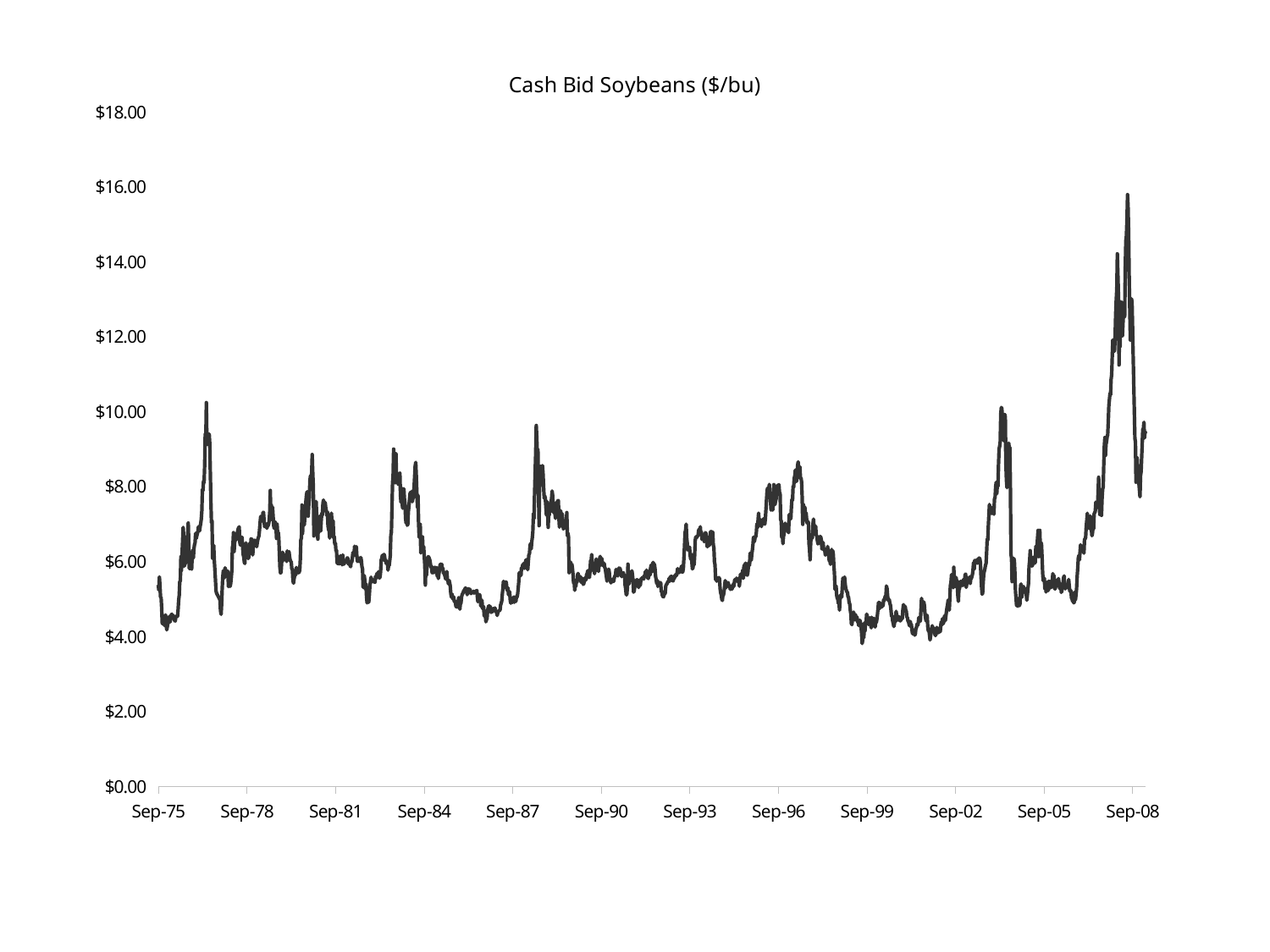
How many date labels are shown on the x axis? 12 Does the line generally rise or fall between Sep-96 and Sep-99? fall Is the peak reached between Sep-75 and Sep-78 greater or less than $8.00? greater What is the highest value shown on the y axis? $18.00 What is the title of the chart? Cash Bid Soybeans ($/bu) Is the peak value reached near Sep-08 greater or less than $14.00? greater Is the value around Sep-02 greater or less than $6.00? less How many lines (series) are plotted on the chart? 1 What kind of chart is shown on the slide? line chart Does the line generally rise or fall between Sep-05 and Sep-08? rise Near which x-axis label does the line reach its highest value? Sep-08